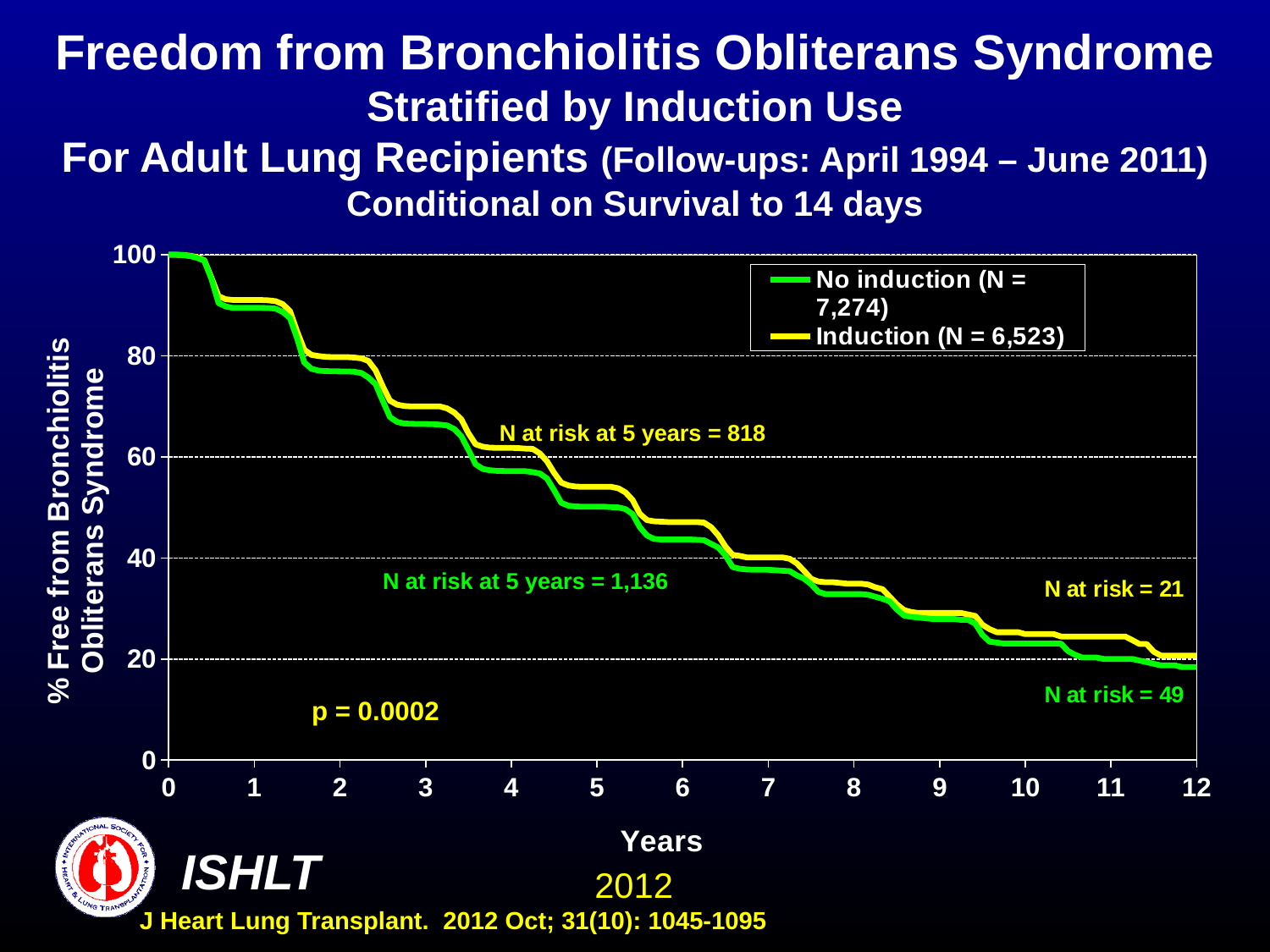
Do the curves rise or fall as years increase along the x axis? fall What is the N at risk at 5 years for the No induction group? 1,136 Is the value for the Induction curve at 5 years greater or less than 60? less At 5 years, which group has the higher % free from Bronchiolitis Obliterans Syndrome, Induction or No induction? Induction What p-value is printed on the chart? p = 0.0002 How many series does the legend list? 2 Which colour is used for the Induction curve? yellow What kind of chart is shown on the slide? line chart What is the N for the No induction group shown in the legend? 7,274 What is the N for the Induction group shown in the legend? 6,523 Is the value for the No induction curve at 3 years greater or less than 60? greater What is the N at risk at 5 years for the Induction group? 818